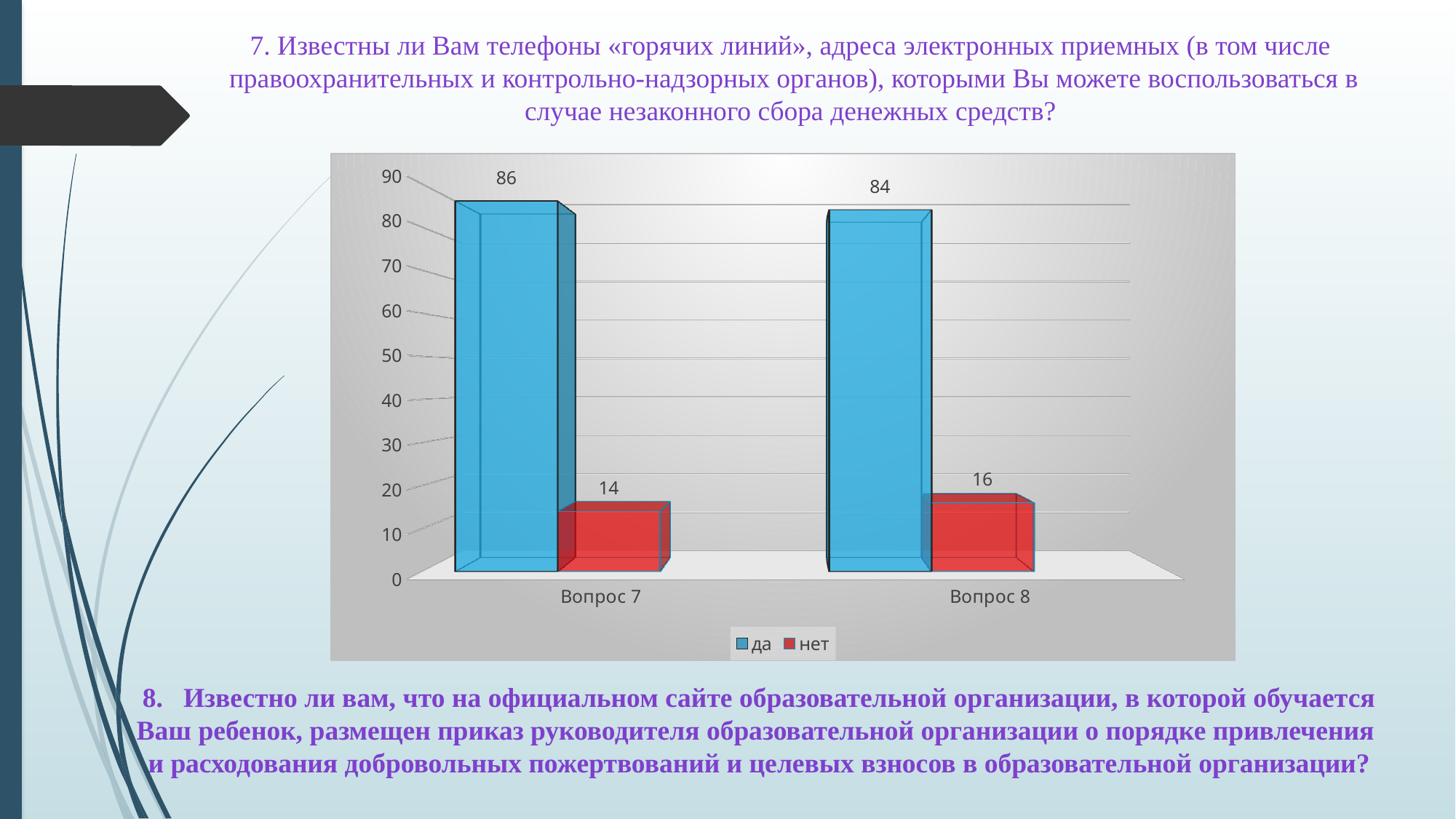
Which is larger: "да" for Вопрос 7 or "да" for Вопрос 8? Вопрос 7 What is the value for "да" for Вопрос 8? 84 What is the difference between the "нет" values for Вопрос 8 and Вопрос 7? 2 How many categories are shown on the x axis? 2 What is the value for "нет" for Вопрос 8? 16 How many series does the legend list? 2 What is the value for "нет" for Вопрос 7? 14 What is the value for "да" for Вопрос 7? 86 Which category has the lowest value for "нет"? Вопрос 7 What is the difference between "да" and "нет" for Вопрос 7? 72 Which category has the highest value for "да"? Вопрос 7 What kind of chart is shown on the slide? Bar chart